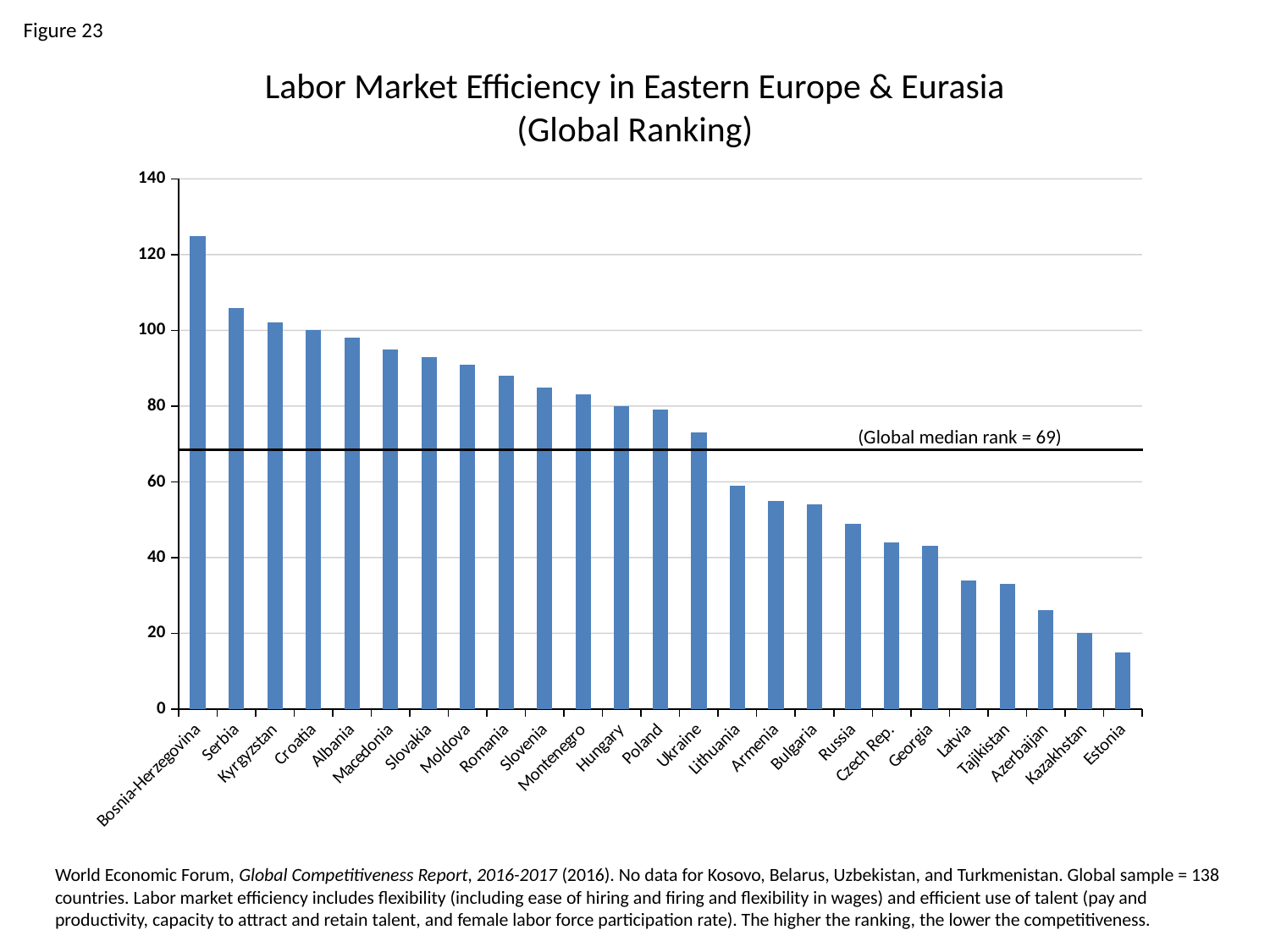
What kind of chart is shown on the slide? bar chart How many countries are shown on the x axis of the chart? 25 Is the value for Russia greater or less than 40? greater Is the value for Ukraine greater or less than 60? greater Which has the larger value, Serbia or Poland? Serbia What global median rank is indicated by the horizontal line on the chart? 69 Do the bar values rise or fall moving from left to right along the x axis? fall Is the value for Bosnia-Herzegovina greater or less than 120? greater Which country has the lowest bar in the chart? Estonia Which country has the highest bar in the chart? Bosnia-Herzegovina